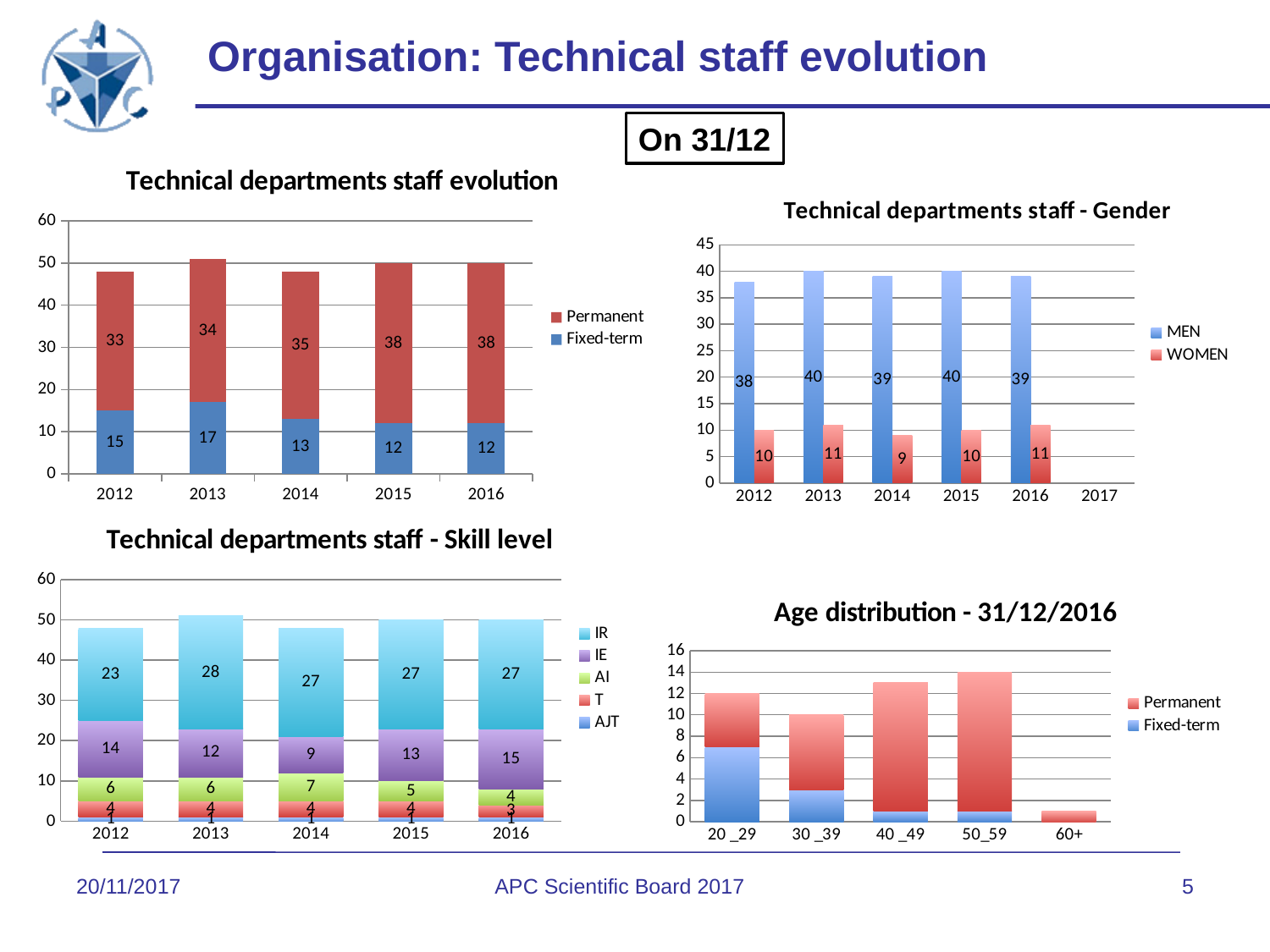
In the 'Technical departments staff evolution' chart, what is the total staff for 2013? 51 In the 'Technical departments staff - Gender' chart, how many series does the legend list? 2 In the 'Age distribution - 31/12/2016' chart, is the total for the 50_59 age group greater or less than 12? greater In the 'Technical departments staff - Gender' chart, what is the WOMEN value for 2014? 9 In the 'Technical departments staff evolution' chart, what is the Permanent value for 2014? 35 In the 'Age distribution - 31/12/2016' chart, which age group has the lowest total? 60+ In the 'Technical departments staff - Skill level' chart, what is the IE value for 2016? 15 In the 'Technical departments staff evolution' chart, which year has the highest Fixed-term value? 2013 In the 'Technical departments staff - Skill level' chart, which year has the lowest IR value? 2012 In the 'Technical departments staff - Gender' chart, what is the difference between MEN and WOMEN in 2012? 28 What kind of chart is the 'Age distribution - 31/12/2016' chart? Stacked bar chart In the 'Technical departments staff - Skill level' chart, how many series does the legend list? 5